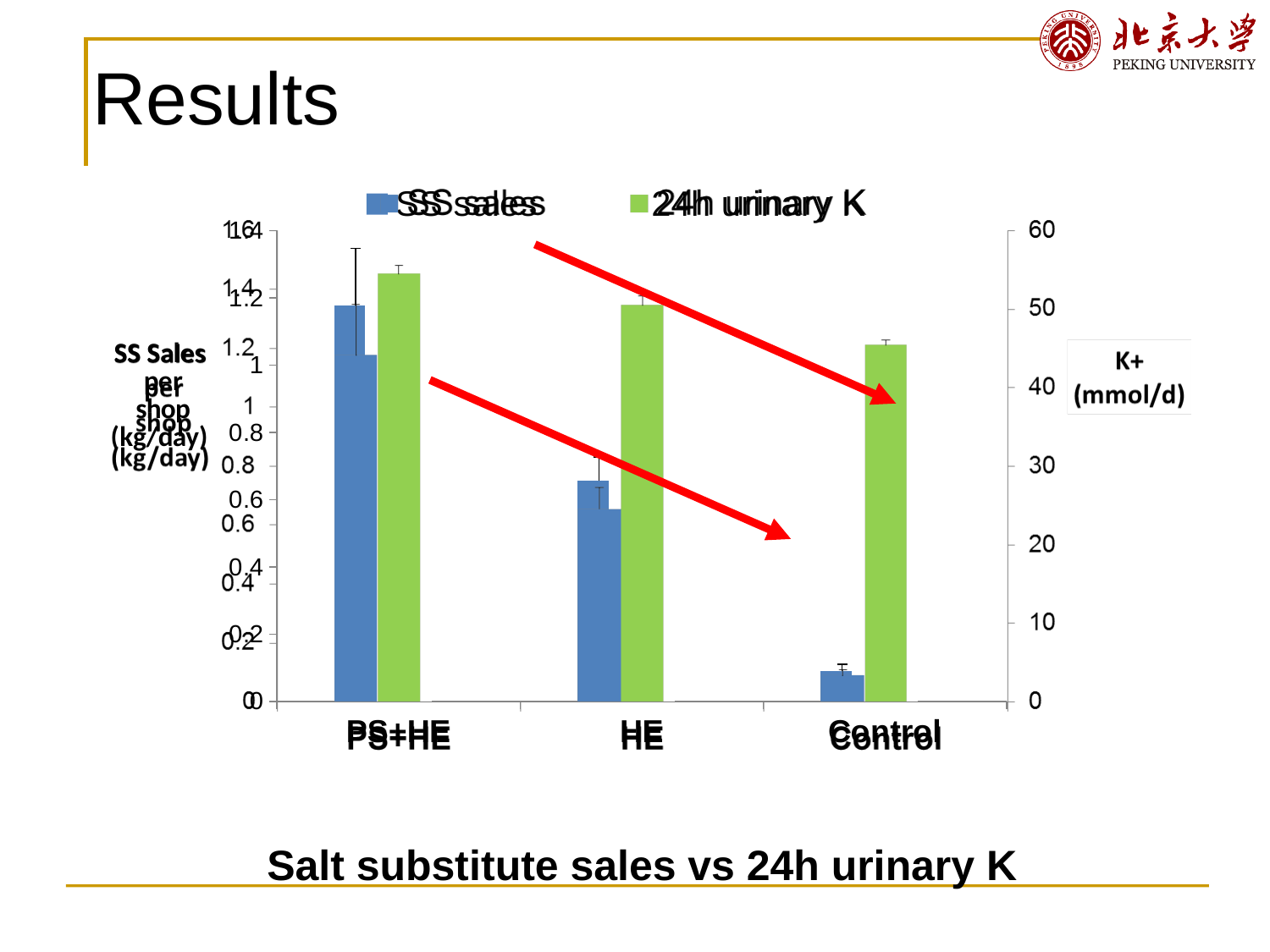
Is the 24h urinary K value for PS+HE greater or less than 50? greater What is the caption below the chart? Salt substitute sales vs 24h urinary K Which is larger, the SS sales value for HE or for Control? HE Which category has the lowest 24h urinary K value? Control How many series does the chart's legend list? 2 Which category has the lowest SS sales value? Control How many categories are shown on the x axis of the chart? 3 Do the SS sales values rise or fall from PS+HE to Control along the x axis? fall Is the 24h urinary K value for Control greater or less than 50? less Which category has the highest SS sales value? PS+HE What kind of chart is shown on the slide? bar chart Which category has the highest 24h urinary K value? PS+HE